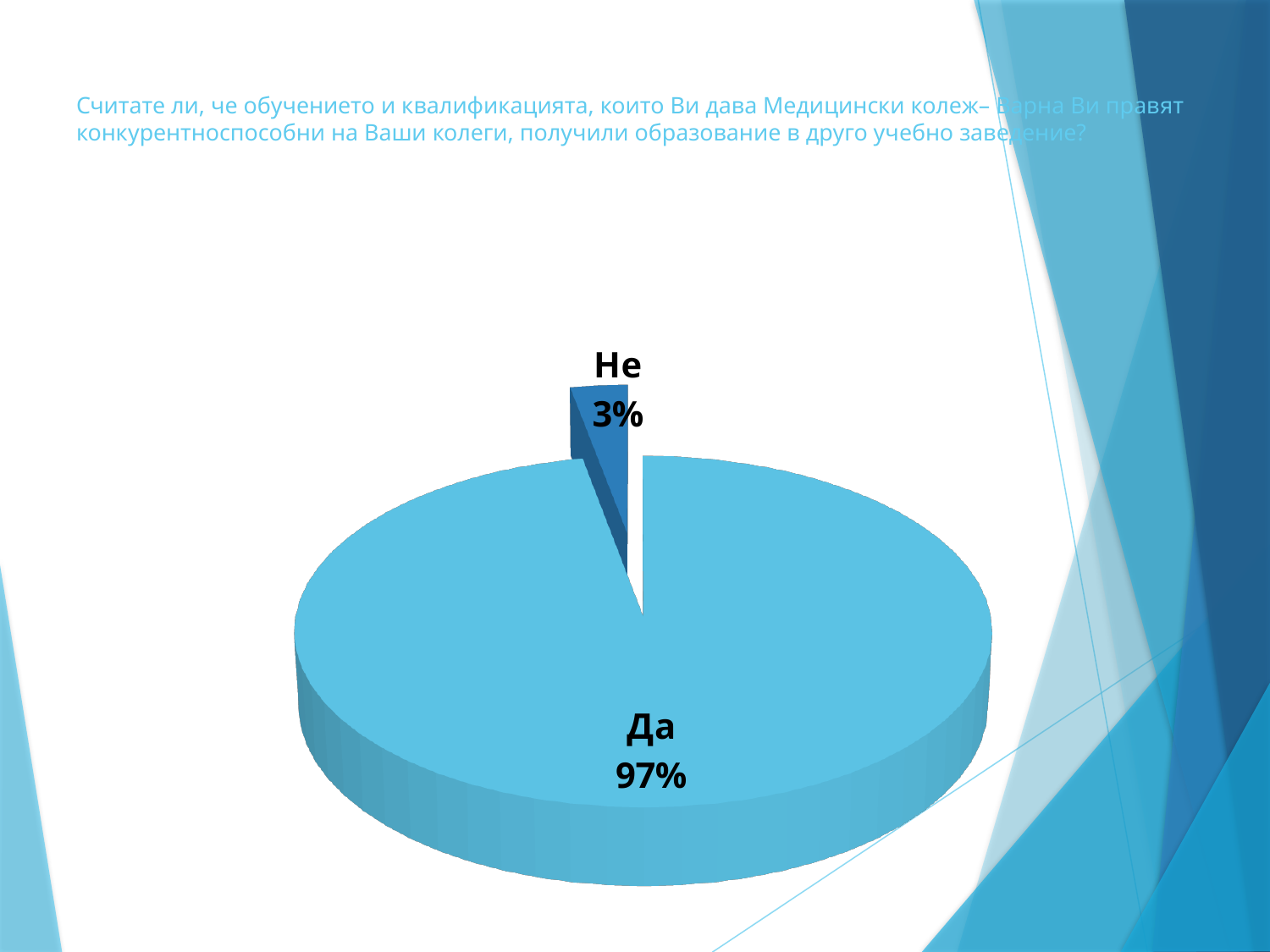
Which is larger, the "Да" slice or the "Не" slice? Да Which slice of the pie is the smallest? Не What share of the pie does the "Не" slice represent? 3% What percentage of respondents answered "Не"? 3% Which slice is drawn in a darker blue and pulled out from the pie? Не What kind of chart is shown on the slide? pie chart Is the value for "Да" greater or less than 50%? greater What is the difference in percentage points between the "Да" and "Не" slices? 94 How many slices does the pie chart have? 2 Which slice of the pie is the largest? Да What percentage of respondents answered "Да"? 97%